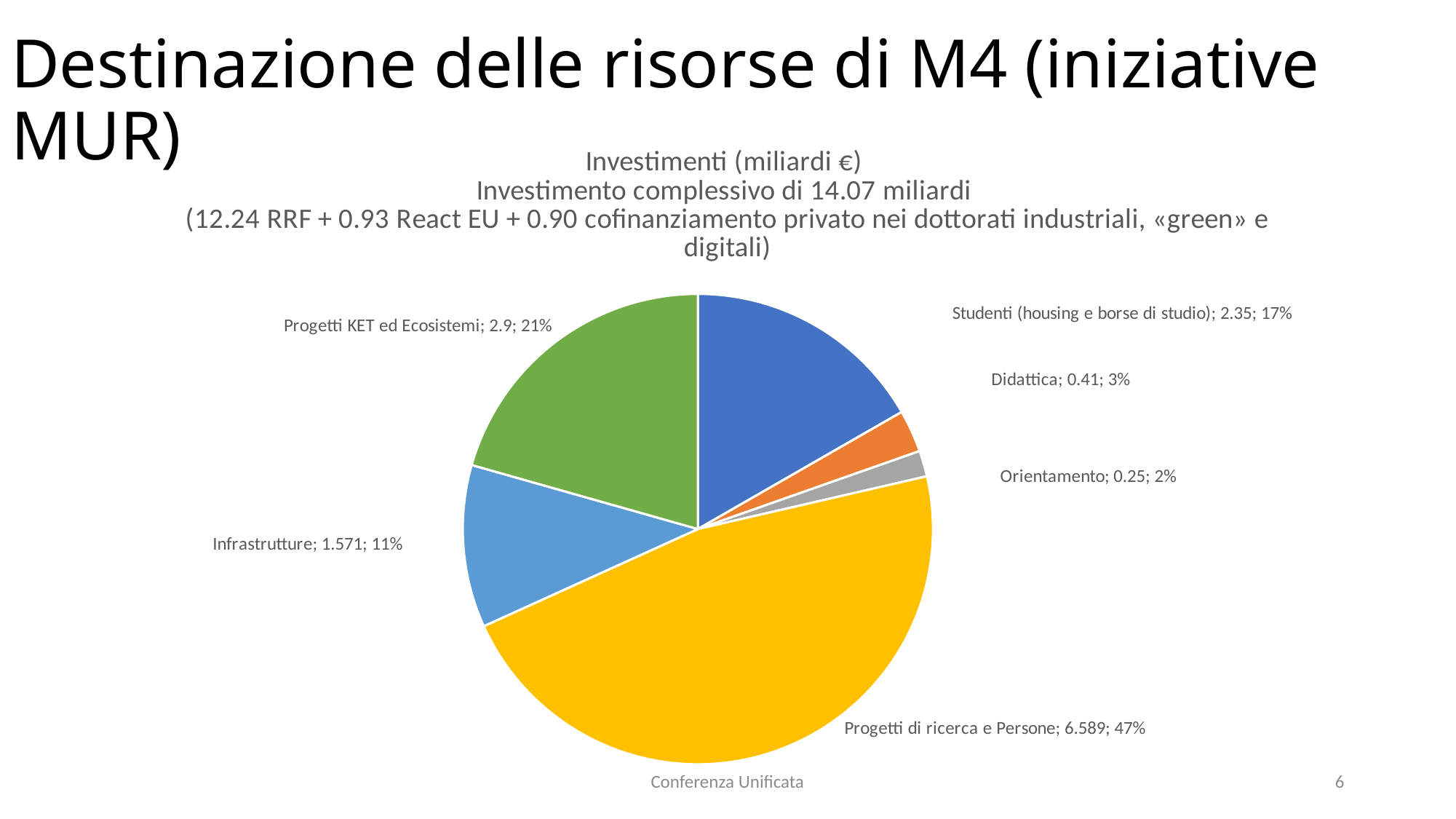
What is the difference between the values for Progetti KET ed Ecosistemi and Studenti (housing e borse di studio)? 0.55 Which category has the smallest slice of the pie? Orientamento Which category has the largest slice of the pie? Progetti di ricerca e Persone What is the value for Didattica? 0.41 What total investment does the chart title state? 14.07 miliardi How many slices does the pie chart have? 6 What share of the pie does Studenti (housing e borse di studio) represent? 17% What is the value for Progetti di ricerca e Persone? 6.589 What share of the pie does Progetti KET ed Ecosistemi represent? 21% What is the value for Infrastrutture? 1.571 Which is larger, the value for Infrastrutture or the value for Studenti (housing e borse di studio)? Studenti (housing e borse di studio) What kind of chart is shown on the slide? pie chart